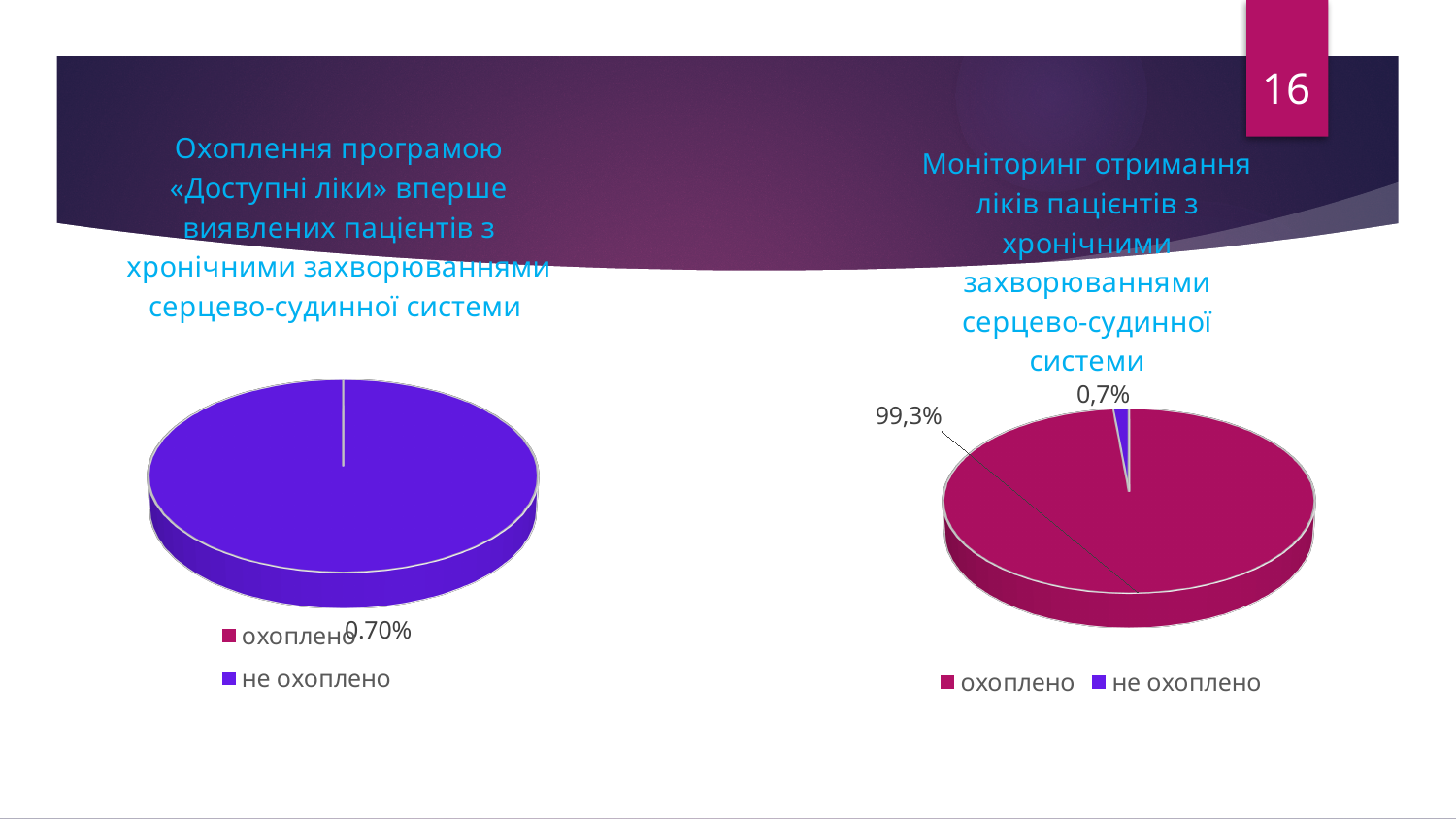
How many entries does the legend of the right chart list? 2 What kind of chart is used on the right side of the slide? pie chart In the right chart (Моніторинг отримання ліків), what share is labelled for охоплено? 99,3% In the right chart (Моніторинг отримання ліків), what share is labelled for не охоплено? 0,7% In the right chart (Моніторинг отримання ліків), which category has the largest slice? охоплено In the right chart (Моніторинг отримання ліків), what is the difference between the охоплено and не охоплено shares? 98,6% In the left chart (Охоплення програмою «Доступні ліки»), which category takes up almost the whole pie? не охоплено How many entries does the legend of the left chart list? 2 What kind of chart is used on the left side of the slide? pie chart In the right chart, what colour is the охоплено slice? magenta In the right chart (Моніторинг отримання ліків), which category has the smallest slice? не охоплено